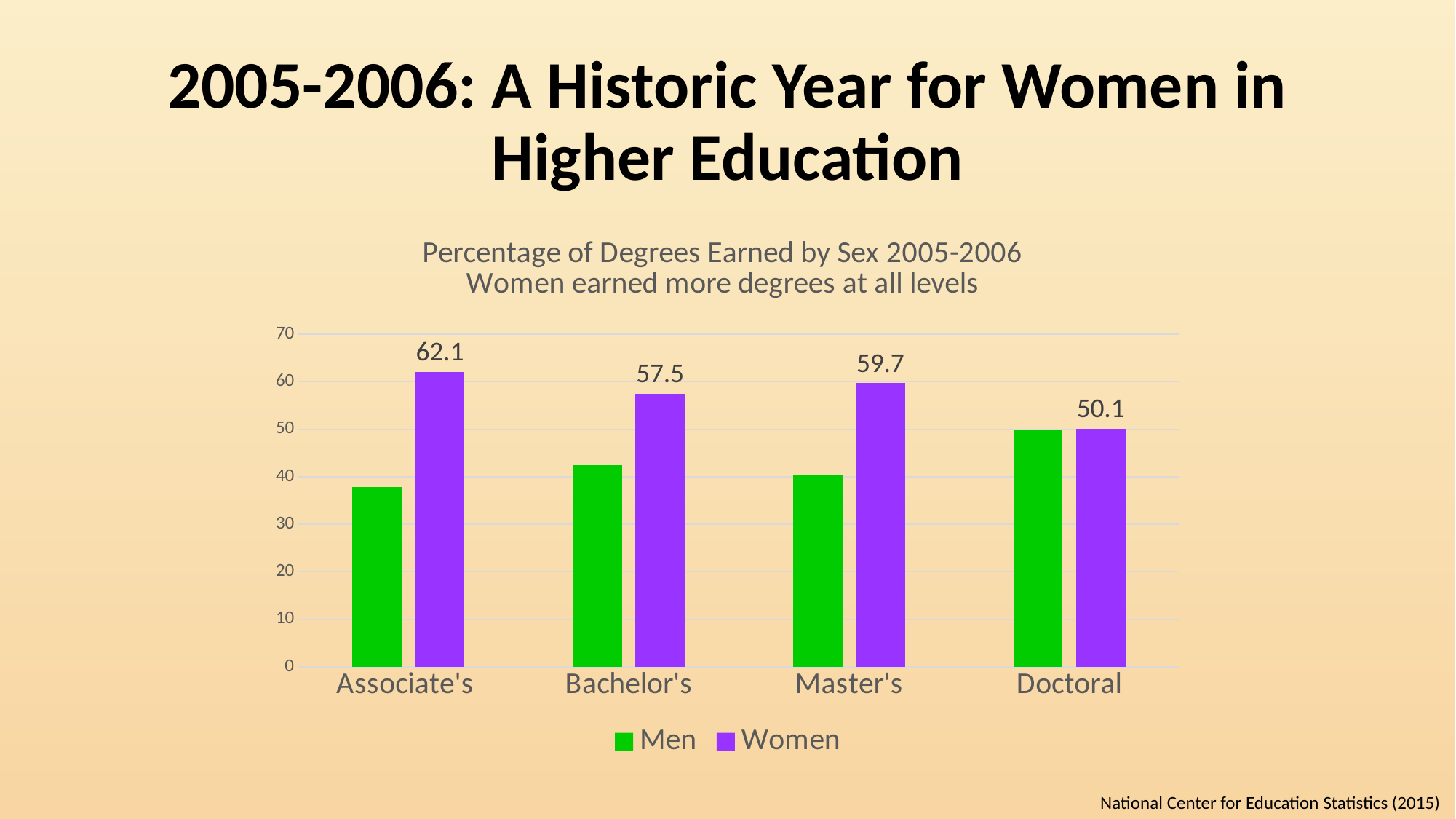
What is the difference between the Women values for Associate's and Bachelor's degrees? 4.6 What percentage of Associate's degrees were earned by women? 62.1 Is the value for Men at the Master's level greater or less than 50? less At which degree level is the Women value highest? Associate's How many series does the legend list? 2 How much higher is the Women value for Master's than for Doctoral? 9.6 At which degree level is the Women value lowest? Doctoral How many degree levels are shown on the x axis? 4 What kind of chart is shown on the slide? bar chart What is the value for Women at the Doctoral level? 50.1 Which has a larger Women value, Bachelor's or Master's? Master's Is the value for Men at the Associate's level greater or less than 40? less